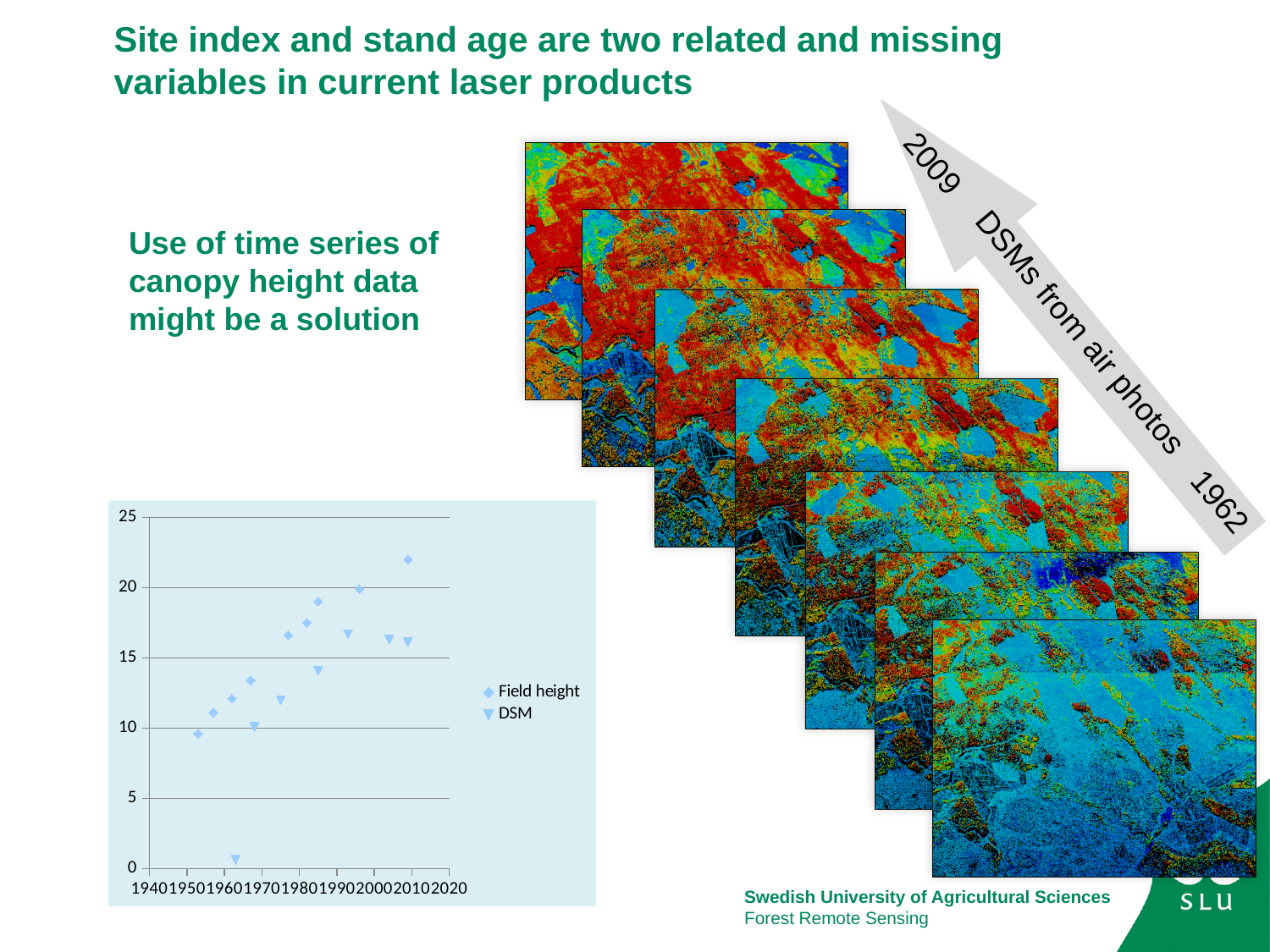
Is the Field height value around 1985 greater or less than 15? greater Do the Field height values generally rise or fall as the year increases? rise What are the two series named in the chart legend? Field height and DSM Around 2010, which series has the larger value, Field height or DSM? Field height Which marker shape is used for the DSM series in the chart? triangle What is the maximum value shown on the chart's vertical axis? 25 What kind of chart is shown on the slide? scatter chart How many series does the chart legend list? 2 Is the DSM value for the most recent year (around 2010) greater or less than 15? greater Is the highest Field height value in the chart greater or less than 20? greater